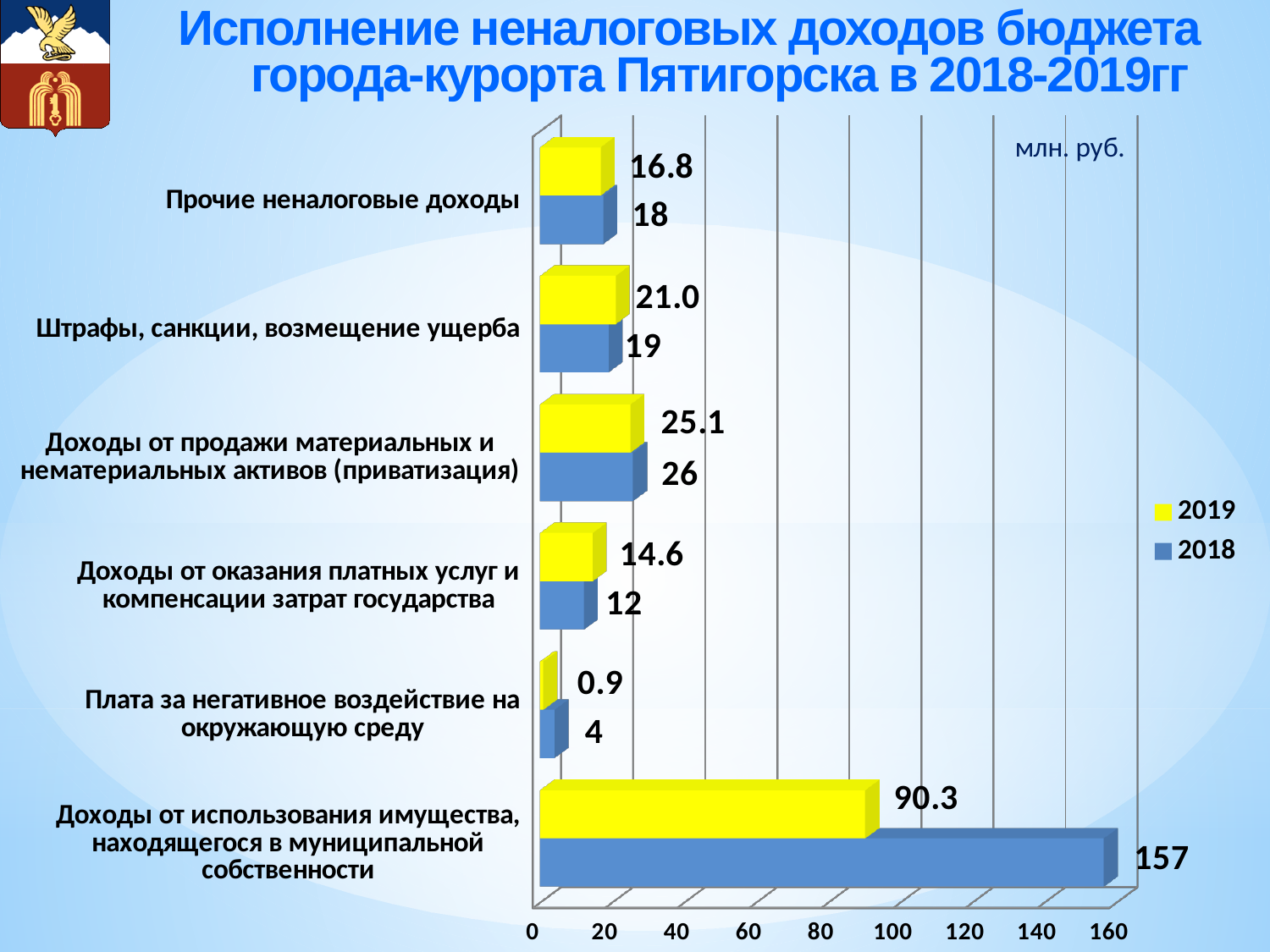
How many categories are shown on the chart? 6 What is the 2019 value for Прочие неналоговые доходы? 16.8 What is the 2018 value for Доходы от использования имущества, находящегося в муниципальной собственности? 157 What is the difference between the 2018 and 2019 values for Доходы от использования имущества, находящегося в муниципальной собственности? 66.7 How many series does the legend list? 2 Is the 2019 value for Доходы от использования имущества, находящегося в муниципальной собственности greater or less than 100? less Which category has the lowest 2018 value? Плата за негативное воздействие на окружающую среду What is the 2019 value for Плата за негативное воздействие на окружающую среду? 0.9 What is the 2018 value for Штрафы, санкции, возмещение ущерба? 19 Which category has the highest 2019 value? Доходы от использования имущества, находящегося в муниципальной собственности What kind of chart is shown on the slide? bar chart Which is larger for Доходы от оказания платных услуг и компенсации затрат государства: the 2019 value or the 2018 value? 2019